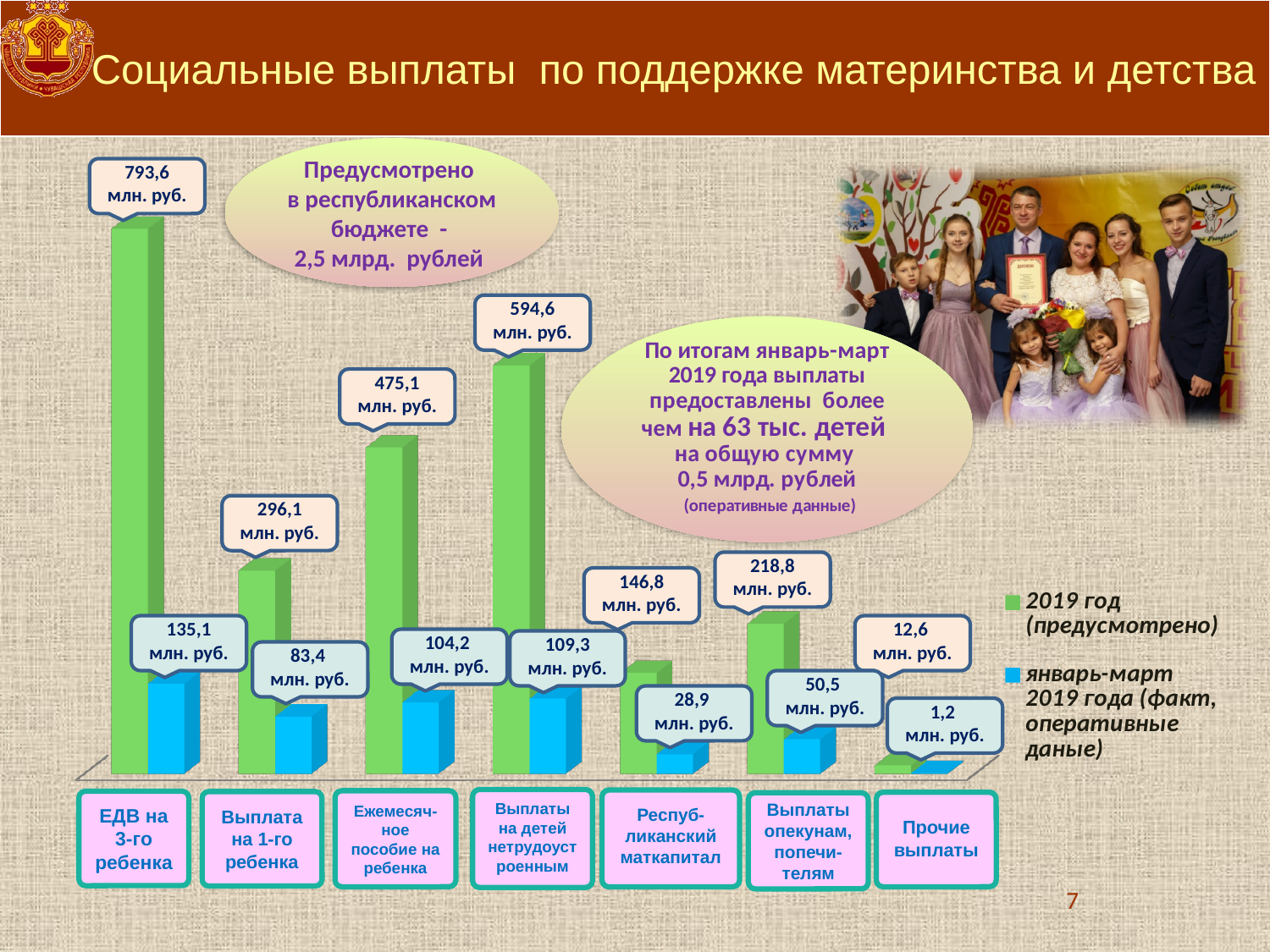
What is the 2019 год (предусмотрено) value for ЕДВ на 3-го ребенка? 793,6 млн. руб. What is the 2019 год (предусмотрено) value for Выплаты опекунам, попечителям? 218,8 млн. руб. Which category has the highest 2019 год (предусмотрено) value? ЕДВ на 3-го ребенка How many series does the legend list? 2 What is the difference between the 2019 год (предусмотрено) and январь-март 2019 года (факт) values for ЕДВ на 3-го ребенка? 658,5 млн. руб. Which category has the lowest январь-март 2019 года (факт) value? Прочие выплаты What is the январь-март 2019 года (факт) value for Республиканский маткапитал? 28,9 млн. руб. How many categories are shown on the chart? 7 What is the difference between the 2019 год (предусмотрено) values for Выплаты на детей нетрудоустроенным and Ежемесячное пособие на ребенка? 119,5 млн. руб. What is the январь-март 2019 года (факт) value for Ежемесячное пособие на ребенка? 104,2 млн. руб. Which is larger: the 2019 год (предусмотрено) value for Выплата на 1-го ребенка or for Выплаты опекунам, попечителям? Выплата на 1-го ребенка What kind of chart is shown on the slide? Bar chart